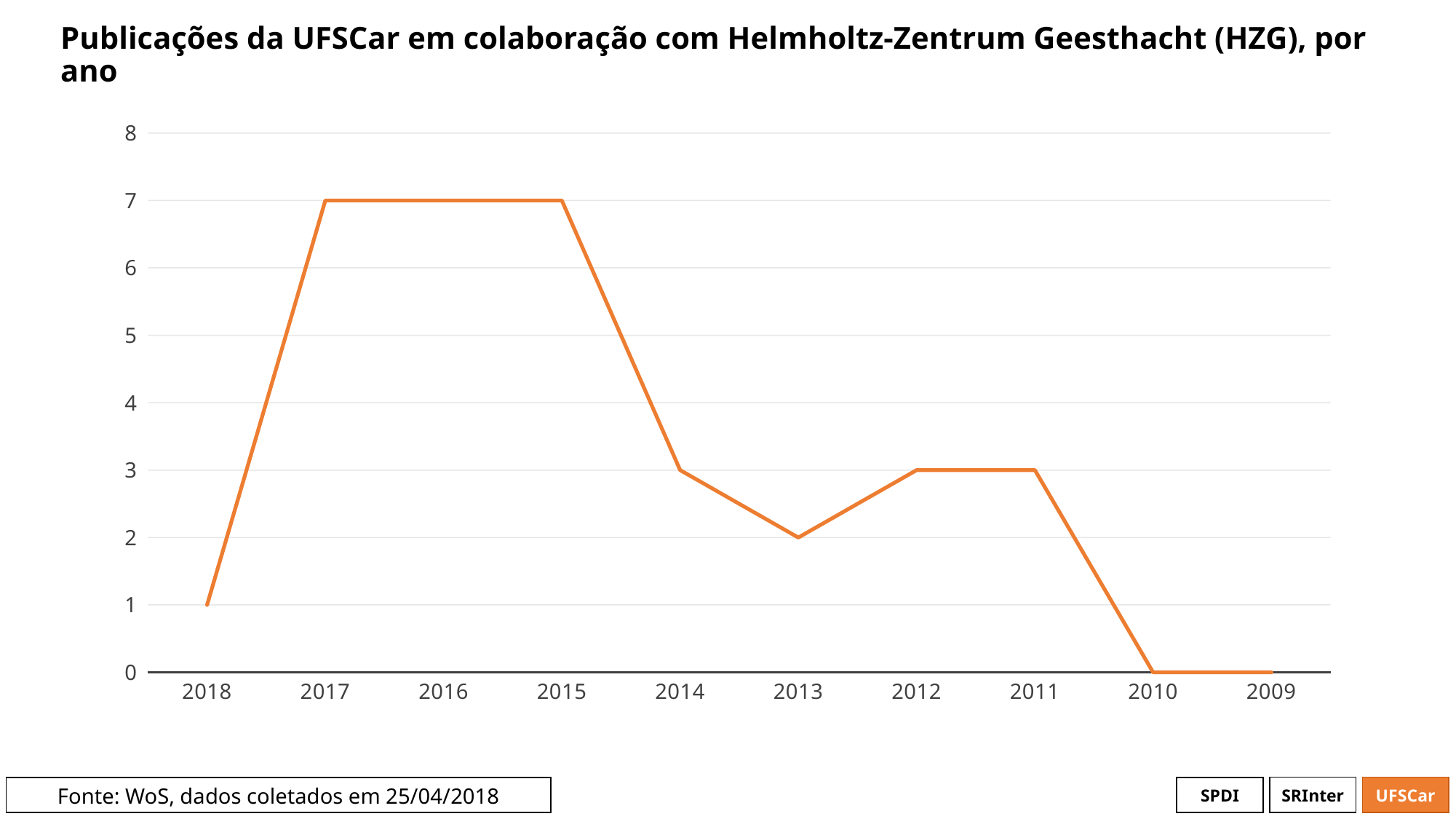
What kind of chart is shown on the slide? line chart Which year has the lowest value other than the years at zero, 2018 or 2013? 2018 Which is larger, the value for 2012 or the value for 2013? 2012 What is the number of publications for 2013? 2 What is the title of the chart? Publicações da UFSCar em colaboração com Helmholtz-Zentrum Geesthacht (HZG), por ano What is the number of publications for 2014? 3 Is the value for 2016 greater or less than 5? greater What is the number of publications for 2018? 1 What is the number of publications for 2010? 0 What is the difference between the value for 2017 and the value for 2014? 4 How many years are plotted on the x axis? 10 Does the line rise or fall from 2015 to 2014? fall